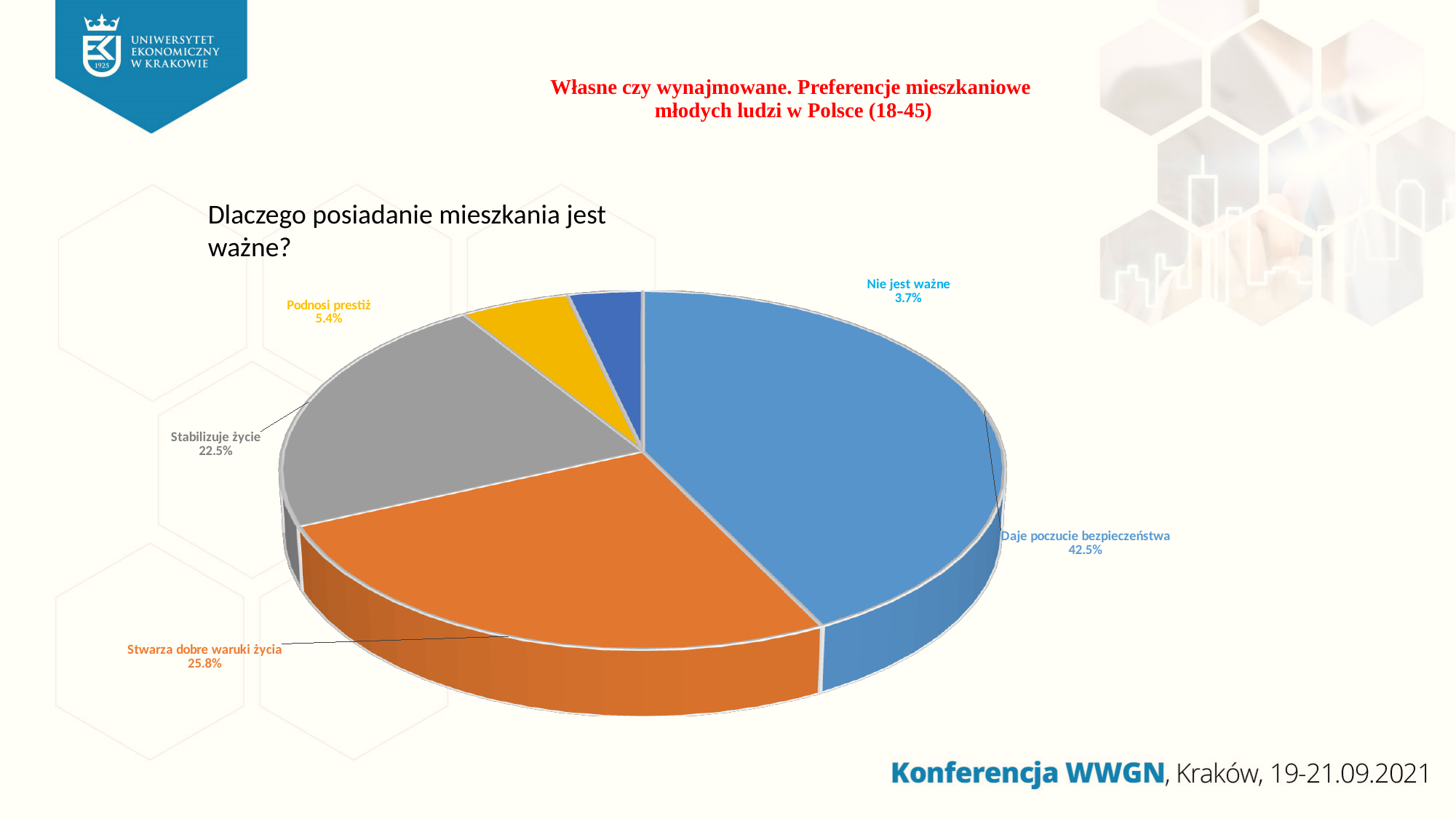
What percentage is shown for "Stabilizuje życie"? 22.5% What type of chart is shown on the slide? Pie chart What percentage is shown for "Podnosi prestiż"? 5.4% What percentage is shown for "Daje poczucie bezpieczeństwa"? 42.5% Which is larger, the share for "Stabilizuje życie" or the share for "Podnosi prestiż"? Stabilizuje życie What is the title of the chart? Dlaczego posiadanie mieszkania jest ważne? Which category has the largest share of the pie? Daje poczucie bezpieczeństwa What percentage is shown for "Nie jest ważne"? 3.7% Which category has the smallest share of the pie? Nie jest ważne How many slices does the pie chart have? 5 What is the difference in percentage points between "Daje poczucie bezpieczeństwa" and "Stwarza dobre waruki życia"? 16.7 What percentage is shown for "Stwarza dobre waruki życia"? 25.8%